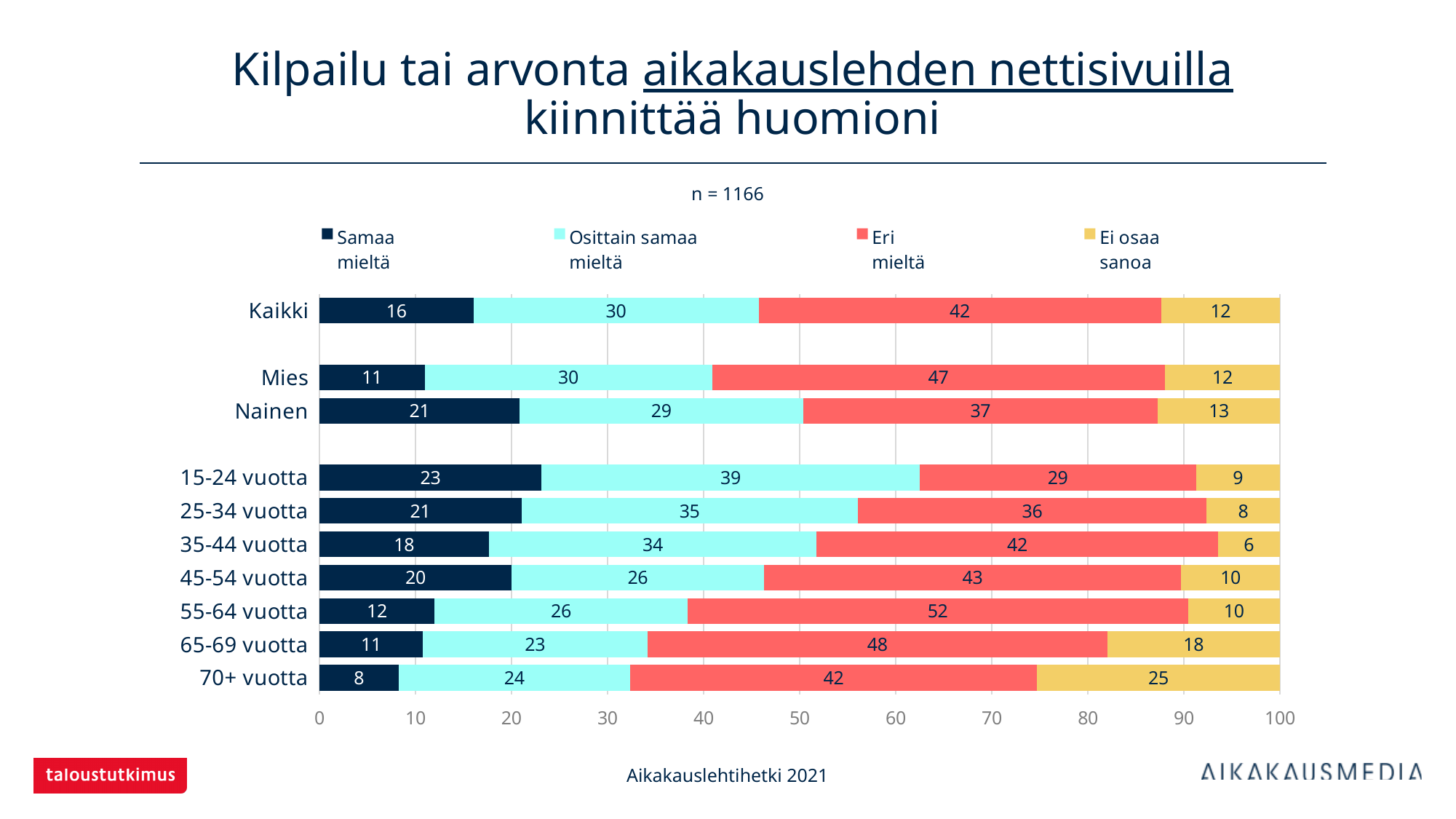
What is the "Ei osaa sanoa" value for 70+ vuotta? 25 What sample size (n) is stated above the chart? n = 1166 What is the "Eri mieltä" value for Mies? 47 What is the total of the stacked bar for 65-69 vuotta? 100 What is the "Samaa mieltä" value for Kaikki? 16 What is the difference between the "Samaa mieltä" values for Nainen and Mies? 10 How many series does the legend list? 4 Which is larger, the "Osittain samaa mieltä" value for 15-24 vuotta or for 25-34 vuotta? 15-24 vuotta Which category has the lowest "Samaa mieltä" value? 70+ vuotta What kind of chart is shown on the slide? Stacked bar chart How many categories are shown on the vertical axis? 10 Which category has the highest "Eri mieltä" value? 55-64 vuotta